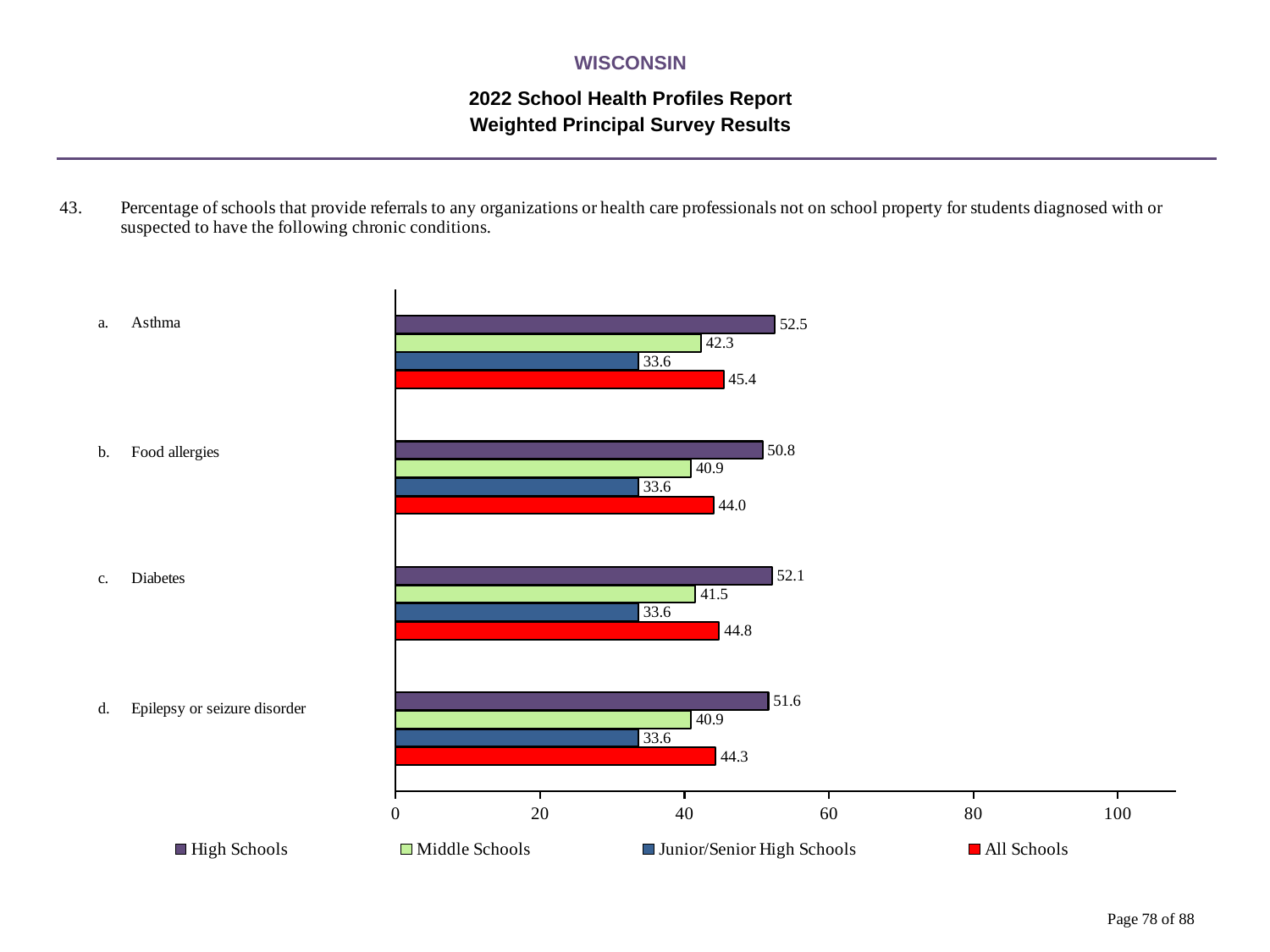
What kind of chart is shown on the slide? bar chart What is the value for Middle Schools for Food allergies? 40.9 Which is larger for Diabetes: the High Schools value or the All Schools value? High Schools What is the difference between the High Schools and Middle Schools values for Asthma? 10.2 Is the value for Middle Schools for Epilepsy or seizure disorder greater or less than 60? less What is the value for All Schools for Diabetes? 44.8 How many series does the legend list? 4 Which chronic condition has the lowest value for All Schools? Food allergies Which chronic condition has the highest value for High Schools? Asthma What is the value for Junior/Senior High Schools for Epilepsy or seizure disorder? 33.6 What is the value for High Schools for Asthma? 52.5 How many chronic conditions are shown on the chart? 4